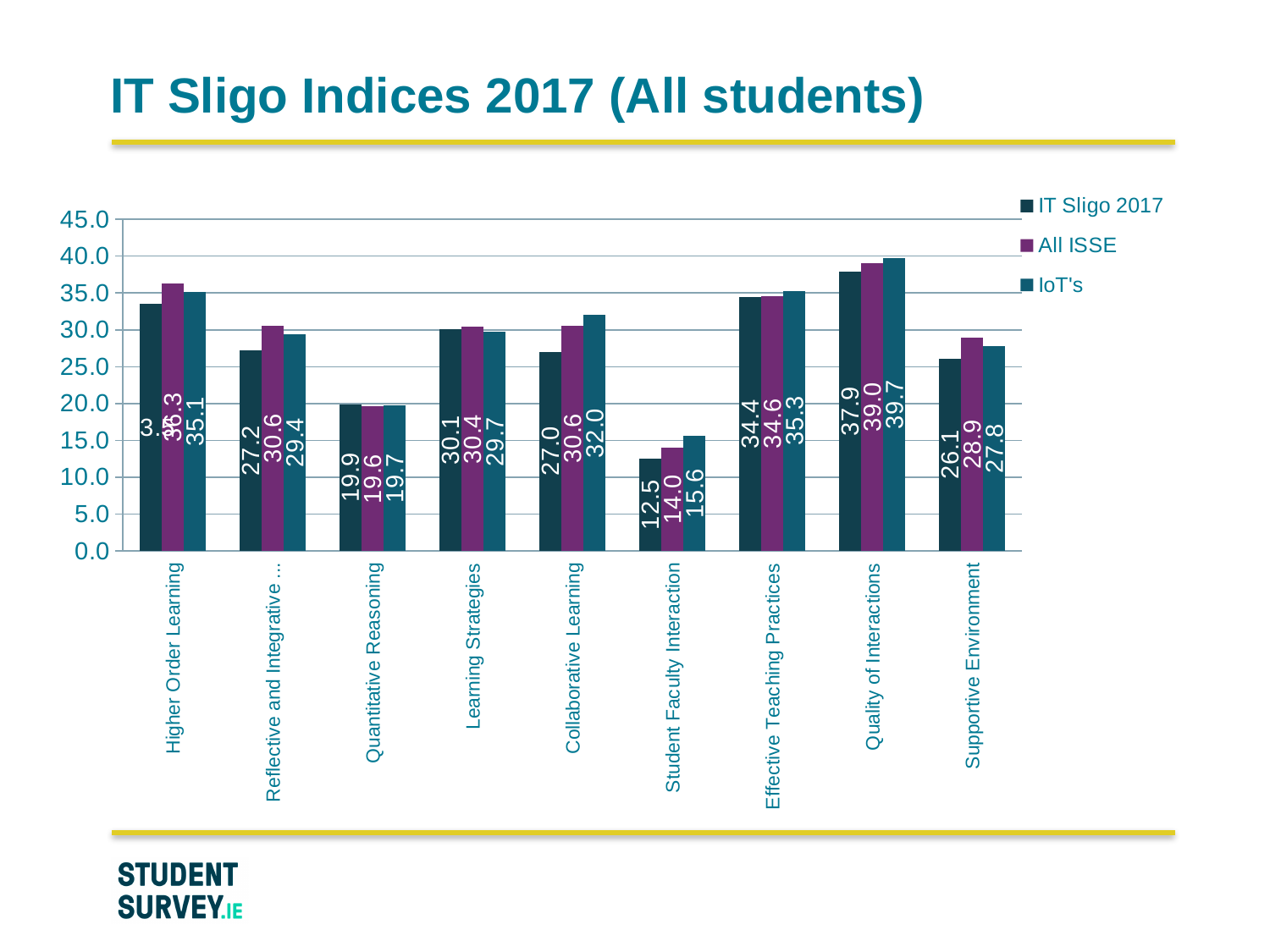
What is the IT Sligo 2017 value for Student Faculty Interaction? 12.5 What kind of chart is shown on the slide? bar chart Which category has the highest IT Sligo 2017 value? Quality of Interactions What is the All ISSE value for Quality of Interactions? 39.0 How many series does the legend list? 3 What is the IoT's value for Collaborative Learning? 32.0 For Collaborative Learning, how much higher is the IoT's value than the IT Sligo 2017 value? 5.0 Which category has the lowest IoT's value? Student Faculty Interaction Is the IT Sligo 2017 value for Higher Order Learning greater or less than 30.0? greater For Supportive Environment, which is larger: the All ISSE value or the IoT's value? All ISSE For Student Faculty Interaction, what is the difference between the IoT's value and the IT Sligo 2017 value? 3.1 How many categories are shown on the x axis? 9